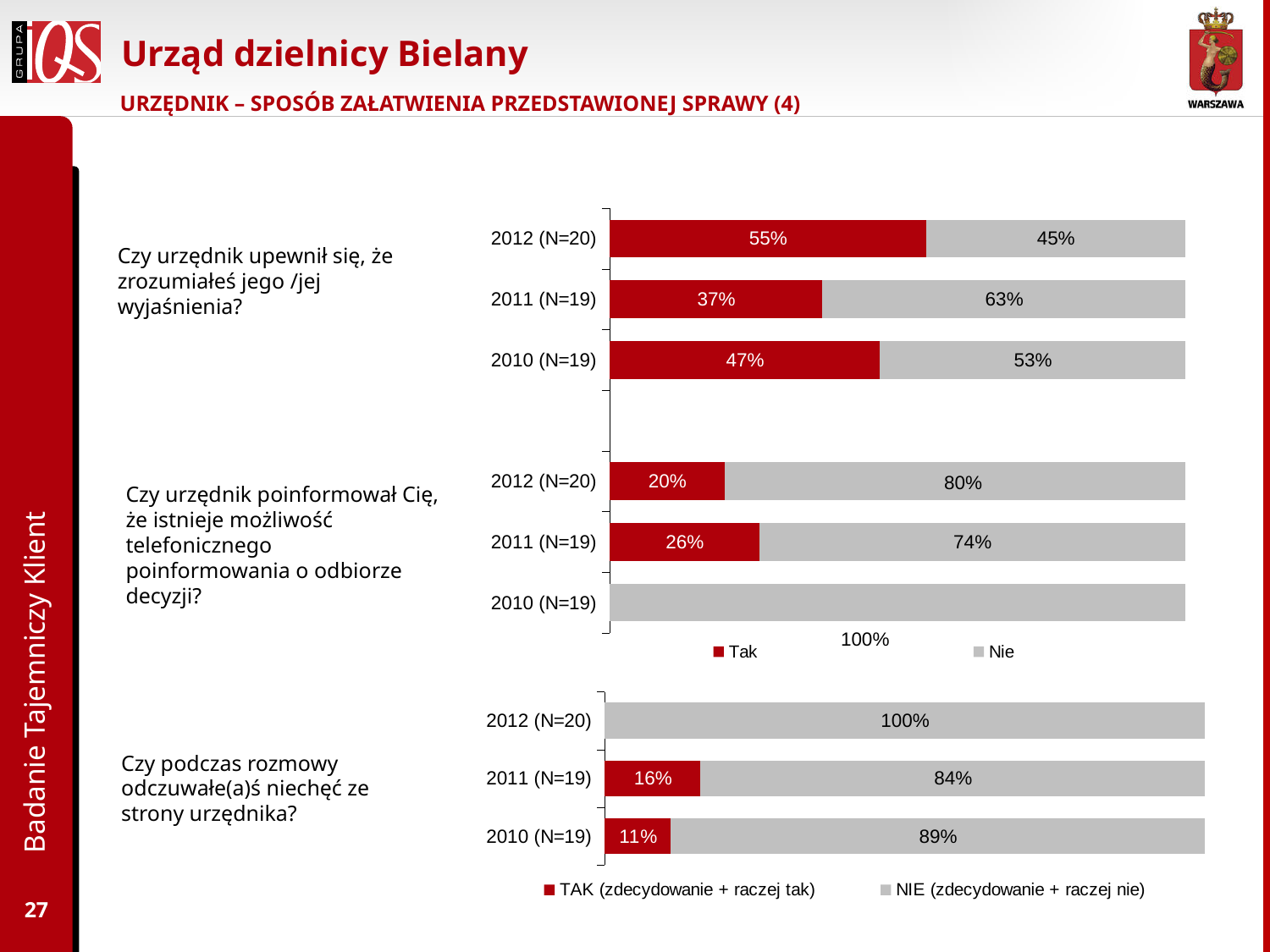
In the upper chart, what is the 'Tak' value for 2012 (N=20) for the question 'Czy urzędnik upewnił się, że zrozumiałeś jego /jej wyjaśnienia?' 55% In the lower chart, what is the 'NIE' value for 2012 (N=20)? 100% In the upper chart, for the question 'Czy urzędnik upewnił się, że zrozumiałeś jego /jej wyjaśnienia?', which year has the highest 'Tak' value? 2012 (N=20) In the upper chart, for the question 'Czy urzędnik upewnił się, że zrozumiałeś jego /jej wyjaśnienia?', which year has the lowest 'Tak' value? 2011 (N=19) In the lower chart, what is the difference between the 'NIE' values for 2010 (N=19) and 2011 (N=19)? 5% In the upper chart, what is the 'Tak' value for 2010 (N=19) for the question 'Czy urzędnik poinformował Cię, że istnieje możliwość telefonicznego poinformowania o odbiorze decyzji?' 0% What type of chart is the lower chart? Stacked bar chart How many series does the legend of the lower chart list? 2 In the lower chart, what is the 'TAK' value for 2010 (N=19)? 11% In the upper chart, what is the 'Nie' value for 2011 (N=19) for the question 'Czy urzędnik upewnił się, że zrozumiałeś jego /jej wyjaśnienia?' 63% In the upper chart, for the question 'Czy urzędnik poinformował Cię, że istnieje możliwość telefonicznego poinformowania o odbiorze decyzji?', is the 'Tak' value larger in 2011 (N=19) or 2012 (N=20)? 2011 (N=19) In the lower chart, does the 'TAK' value rise or fall from 2010 (N=19) to 2012 (N=20)? Fall